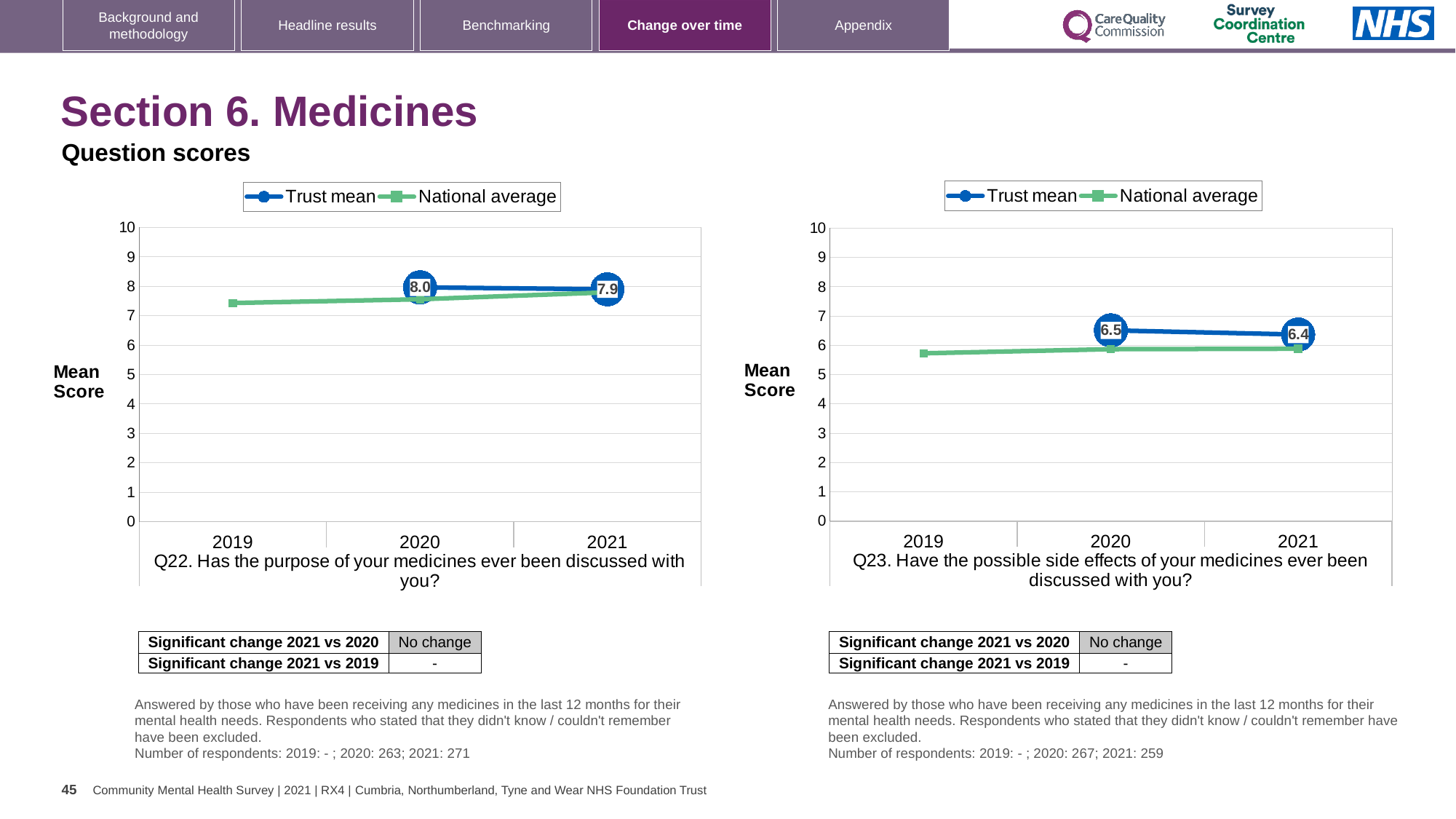
In the Q22 chart on the left, is the National average for 2019 greater or less than 7? greater In the Q23 chart on the right, what is the Trust mean for 2021? 6.4 What kind of chart is the Q22 chart on the left? line chart How many series does the legend of the Q23 chart on the right list? 2 In the Q22 chart on the left, what is the Trust mean for 2020? 8.0 In the Q23 chart on the right, is the National average for 2019 greater or less than 6? less In the Q23 chart on the right, which is larger in 2021, the Trust mean or the National average? Trust mean In the Q23 chart on the right, does the Trust mean rise or fall from 2020 to 2021? fall In the Q22 chart on the left, what is the difference between the Trust mean in 2020 and in 2021? 0.1 In the Q23 chart on the right, what is the Trust mean for 2020? 6.5 How many years are shown on the x axis of the Q22 chart on the left? 3 In the Q22 chart on the left, what is the Trust mean for 2021? 7.9